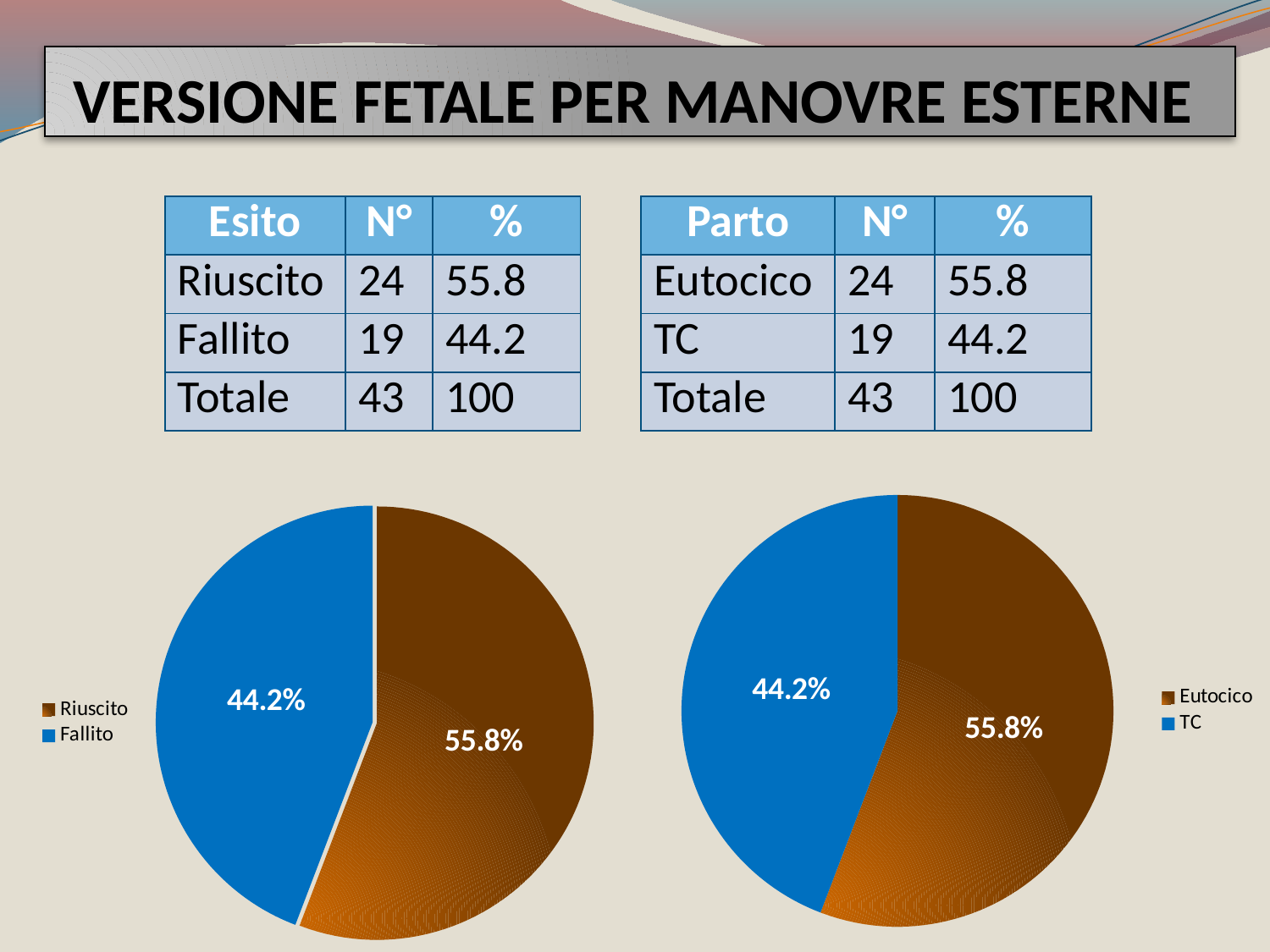
In the right pie chart (Eutocico/TC), what colour is the TC slice? Blue In the right pie chart (Eutocico/TC), which slice is the smallest? TC In the left pie chart (Riuscito/Fallito), which slice is the largest? Riuscito In the left pie chart (Riuscito/Fallito), which is larger, Riuscito or Fallito? Riuscito What kind of chart is the left chart (Riuscito/Fallito)? Pie chart How many slices does the right pie chart (Eutocico/TC) have? 2 In the right pie chart (Eutocico/TC), what share does the Eutocico slice have? 55.8% In the right pie chart (Eutocico/TC), what is the difference in percentage points between the Eutocico and TC slices? 11.6 How many entries does the legend of the left pie chart (Riuscito/Fallito) list? 2 In the left pie chart (Riuscito/Fallito), what share does the Fallito slice have? 44.2% In the right pie chart (Eutocico/TC), what share does the TC slice have? 44.2%